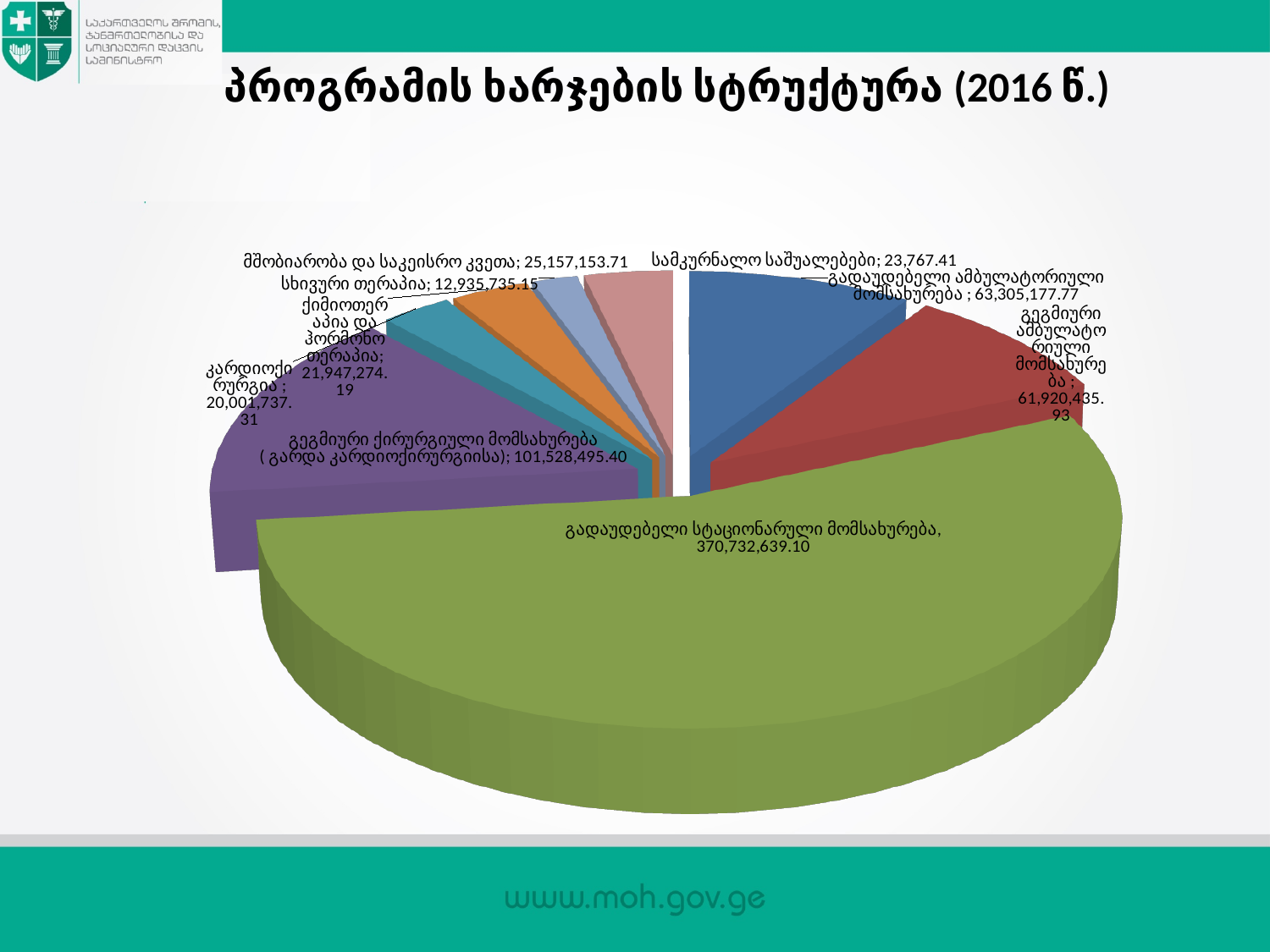
Which is larger: გადაუდებელი ამბულატორიული მომსახურება or გეგმიური ამბულატორიული მომსახურება? გადაუდებელი ამბულატორიული მომსახურება What is the value for გადაუდებელი სტაციონარული მომსახურება? 370,732,639.10 What is the difference between მშობიარობა და საკეისრო კვეთა and სხივური თერაპია? 12,221,418.56 What is the value for სხივური თერაპია? 12,935,735.15 What is the value for სამკურნალო საშუალებები? 23,767.41 How many slices does the pie chart have? 9 What is the value for კარდიოქირურგია? 20,001,737.31 What is the value for გეგმიური ქირურგიული მომსახურება (გარდა კარდიოქირურგიისა)? 101,528,495.40 Which category has the smallest value? სამკურნალო საშუალებები What kind of chart is shown on the slide? pie chart Which category has the largest slice of the pie? გადაუდებელი სტაციონარული მომსახურება What is the title of the chart on the slide? პროგრამის ხარჯების სტრუქტურა (2016 წ.)